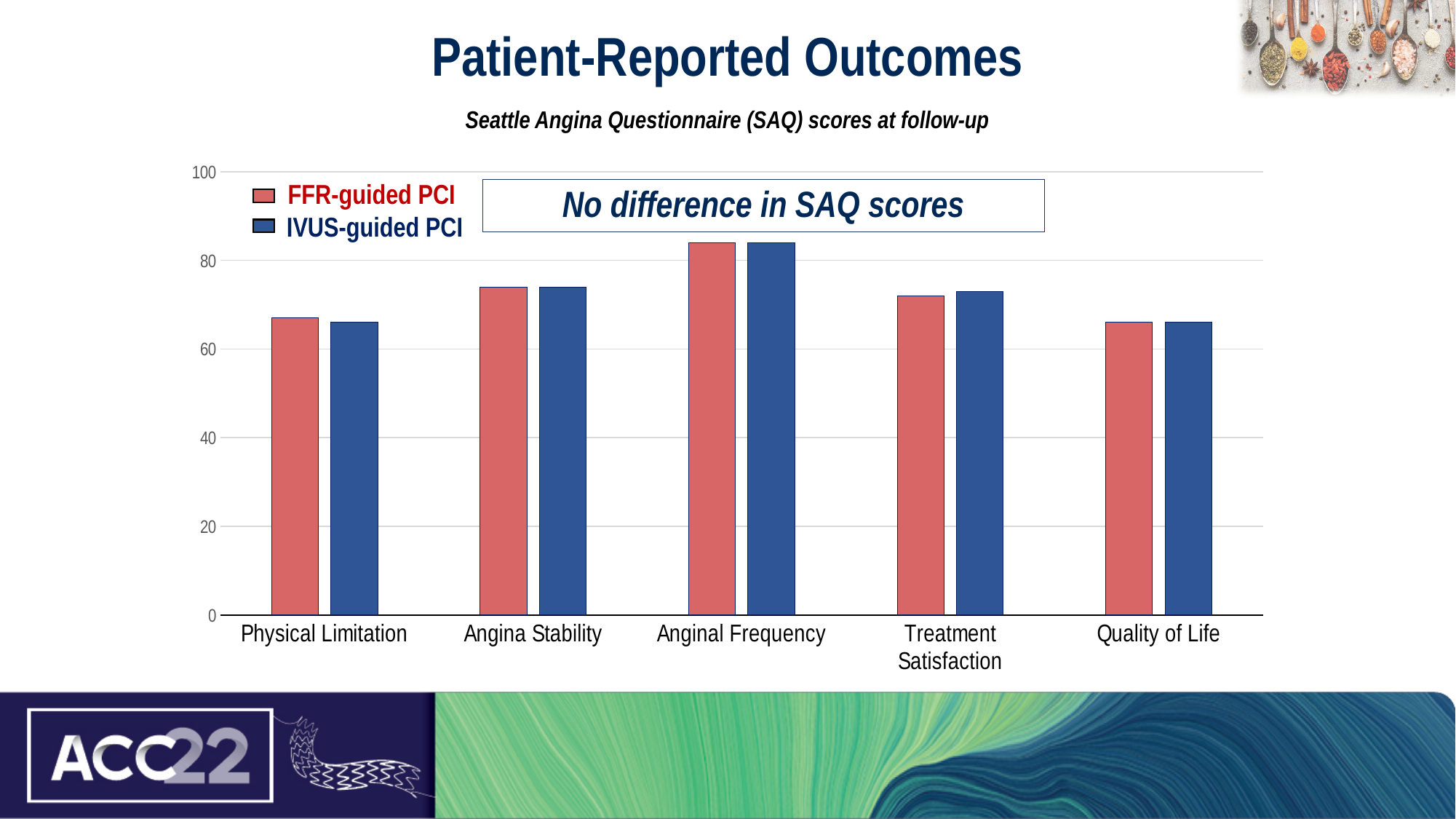
What is the subtitle of the chart? Seattle Angina Questionnaire (SAQ) scores at follow-up Which category has the highest FFR-guided PCI score? Anginal Frequency What type of chart is shown on the slide? bar chart Which is larger for IVUS-guided PCI: Anginal Frequency or Quality of Life? Anginal Frequency Which category has the highest IVUS-guided PCI score? Anginal Frequency How many series does the legend list? 2 How many categories are shown on the x axis? 5 Is the FFR-guided PCI value for Angina Stability greater or less than 80? less Is the IVUS-guided PCI value for Physical Limitation greater or less than 60? greater Which colour represents FFR-guided PCI in the legend? red Is the IVUS-guided PCI value for Quality of Life greater or less than 80? less